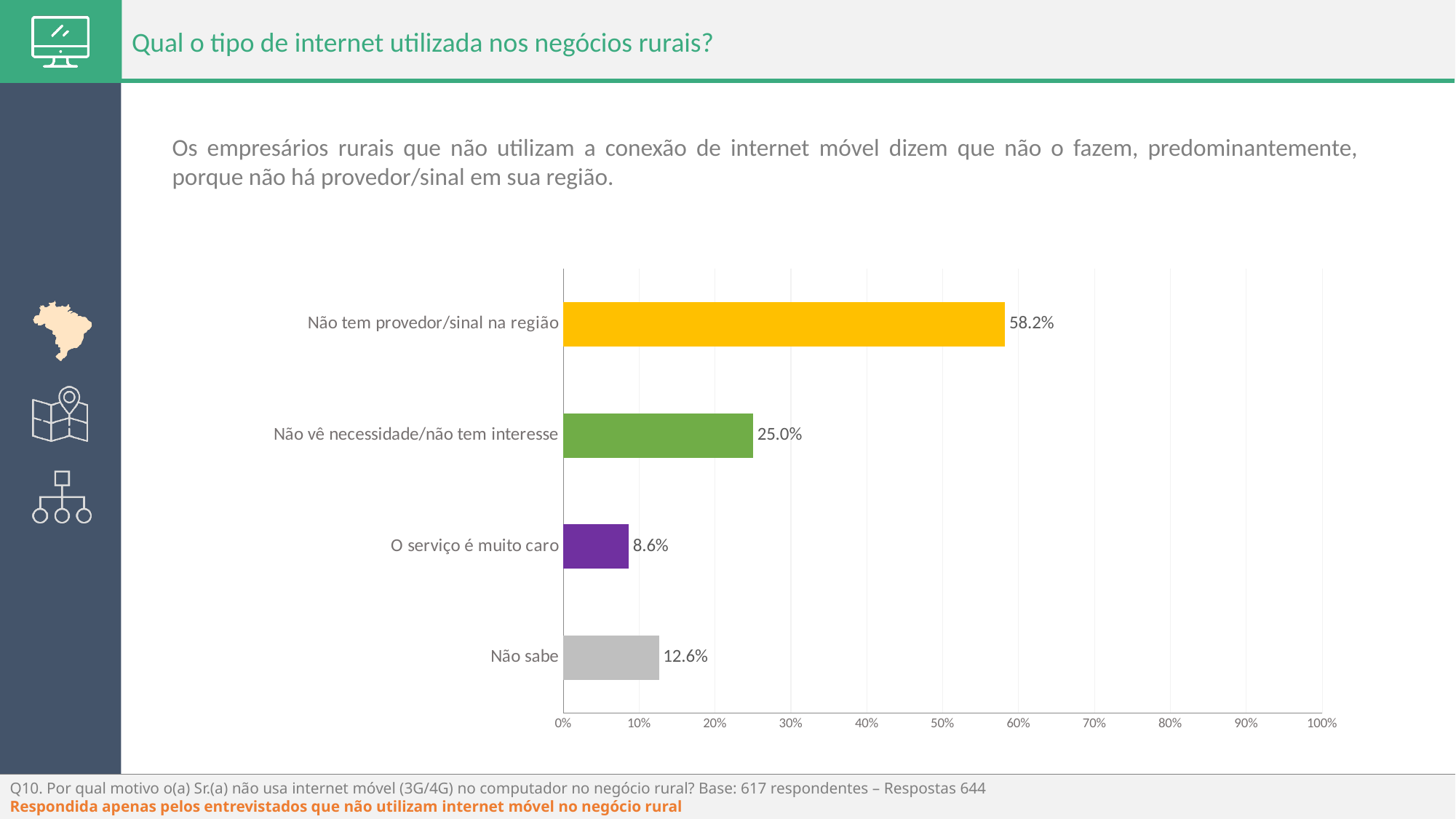
Which is larger, "Não sabe" or "O serviço é muito caro"? Não sabe What is the value for "Não tem provedor/sinal na região"? 58.2% What is the difference between "Não sabe" and "O serviço é muito caro"? 4.0% What is the value for "Não sabe"? 12.6% What kind of chart is shown on the slide? Bar chart Is the value for "Não tem provedor/sinal na região" greater or less than 50%? greater Which category has the highest value? Não tem provedor/sinal na região What is the difference between "Não tem provedor/sinal na região" and "Não vê necessidade/não tem interesse"? 33.2% How many categories are shown in the chart? 4 What is the value for "O serviço é muito caro"? 8.6% What is the value for "Não vê necessidade/não tem interesse"? 25.0% Which category has the lowest value? O serviço é muito caro